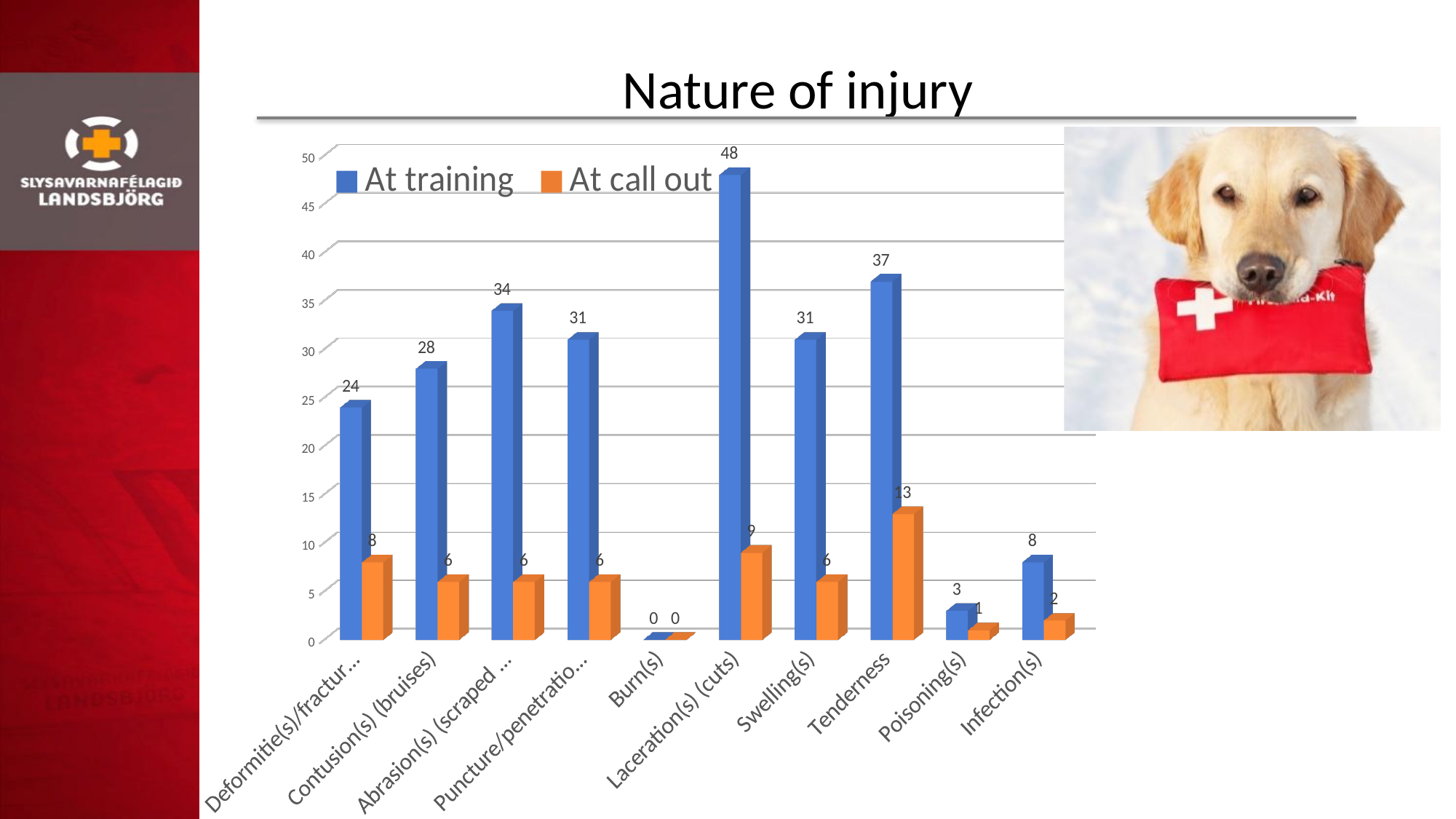
How many injury categories are shown on the x axis? 10 What is the At training value for Contusion(s) (bruises)? 28 Which category has the highest At training value? Laceration(s) (cuts) What is the At call out value for Infection(s)? 2 What is the At training value for Laceration(s) (cuts)? 48 What is the title of the chart? Nature of injury What is the At call out value for Tenderness? 13 How many series does the legend list? 2 Which is larger, the At training value for Swelling(s) or the At training value for Tenderness? Tenderness What kind of chart is shown on the slide? Bar chart Which category has the lowest At call out value? Burn(s) What is the difference between the At training and At call out values for Tenderness? 24